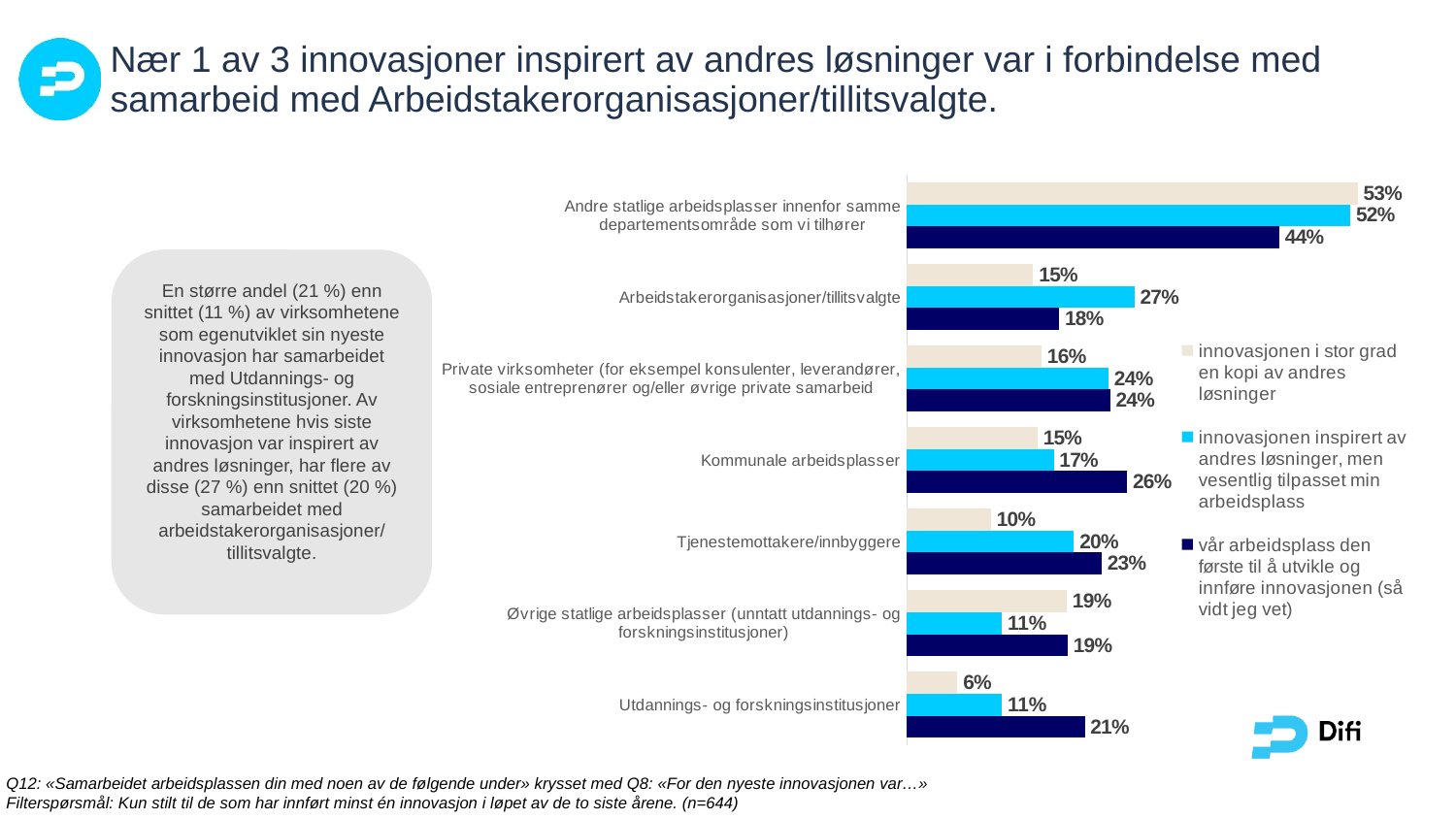
Which category has the lowest value in the series "innovasjonen i stor grad en kopi av andres løsninger"? Utdannings- og forskningsinstitusjoner How many categories are shown on the chart? 7 Which category has the highest value in the series "innovasjonen i stor grad en kopi av andres løsninger"? Andre statlige arbeidsplasser innenfor samme departementsområde som vi tilhører For Kommunale arbeidsplasser, which series has the larger value: "innovasjonen inspirert av andres løsninger" or "vår arbeidsplass den første til å utvikle og innføre innovasjonen"? vår arbeidsplass den første til å utvikle og innføre innovasjonen (så vidt jeg vet) What is the value for Arbeidstakerorganisasjoner/tillitsvalgte in the series "innovasjonen inspirert av andres løsninger, men vesentlig tilpasset min arbeidsplass"? 27% What is the difference between the "innovasjonen inspirert av andres løsninger" value and the "innovasjonen i stor grad en kopi av andres løsninger" value for Arbeidstakerorganisasjoner/tillitsvalgte? 12% Which colour represents the series "vår arbeidsplass den første til å utvikle og innføre innovasjonen (så vidt jeg vet)"? Dark blue What is the value for Tjenestemottakere/innbyggere in the series "innovasjonen i stor grad en kopi av andres løsninger"? 10% How many series does the legend list? 3 What is the value for Øvrige statlige arbeidsplasser (unntatt utdannings- og forskningsinstitusjoner) in the series "innovasjonen inspirert av andres løsninger, men vesentlig tilpasset min arbeidsplass"? 11% What is the value for Utdannings- og forskningsinstitusjoner in the series "vår arbeidsplass den første til å utvikle og innføre innovasjonen (så vidt jeg vet)"? 21% What kind of chart is shown on the slide? Bar chart